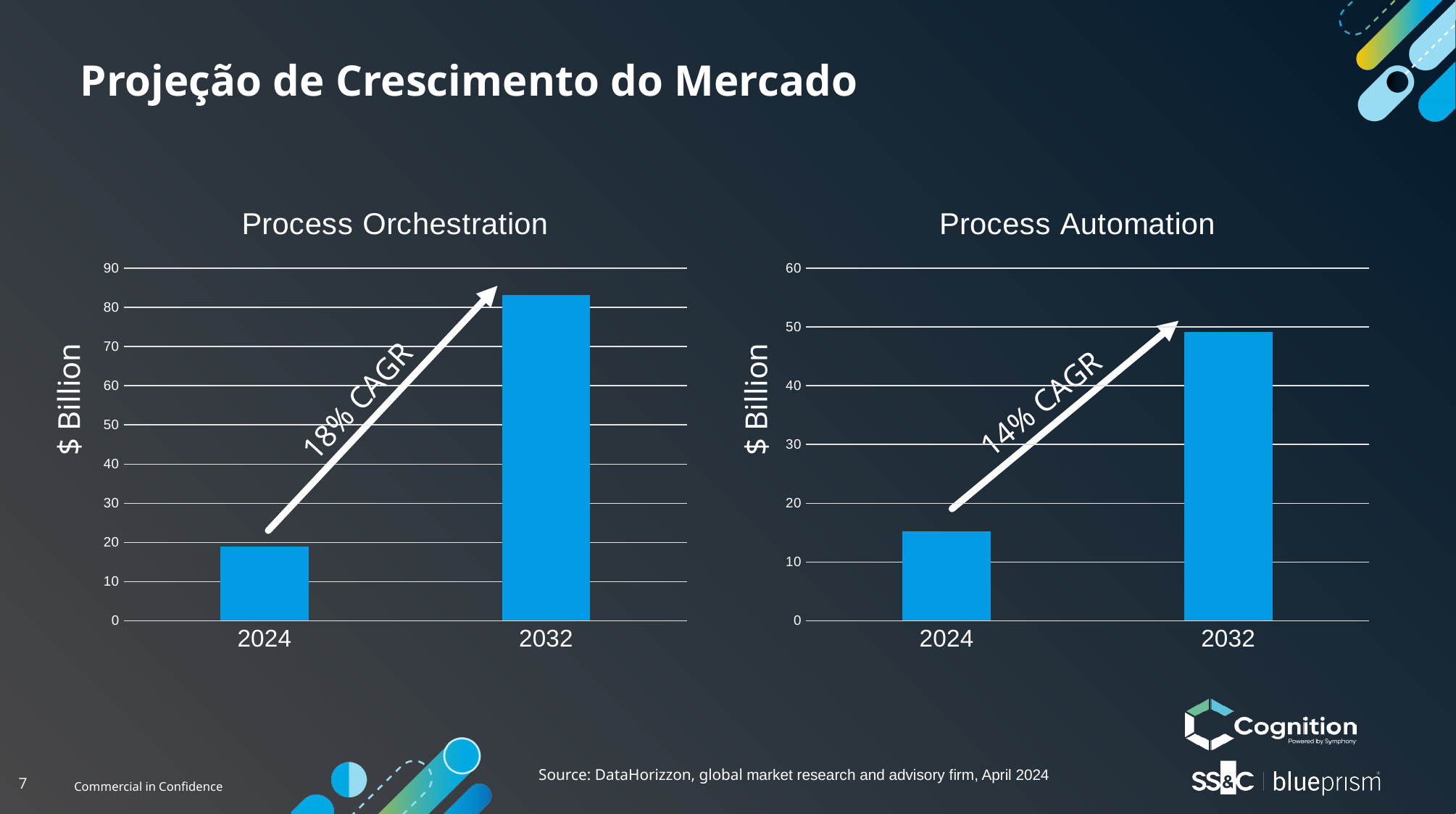
In the Process Automation chart, is the value for 2032 greater or less than 40? greater In the Process Orchestration chart, which year has the higher value, 2024 or 2032? 2032 What kind of chart is the Process Orchestration chart? bar chart In the Process Automation chart, do the values rise or fall from 2024 to 2032? rise What kind of chart is the Process Automation chart? bar chart What is the y-axis title of the Process Automation chart? $ Billion In the Process Orchestration chart, is the value for 2024 greater or less than 30? less In the Process Automation chart, is the value for 2024 greater or less than 20? less In the Process Automation chart, how many bars are plotted? 2 In the Process Orchestration chart, how many years are shown on the x axis? 2 What CAGR is annotated on the Process Orchestration chart? 18% CAGR